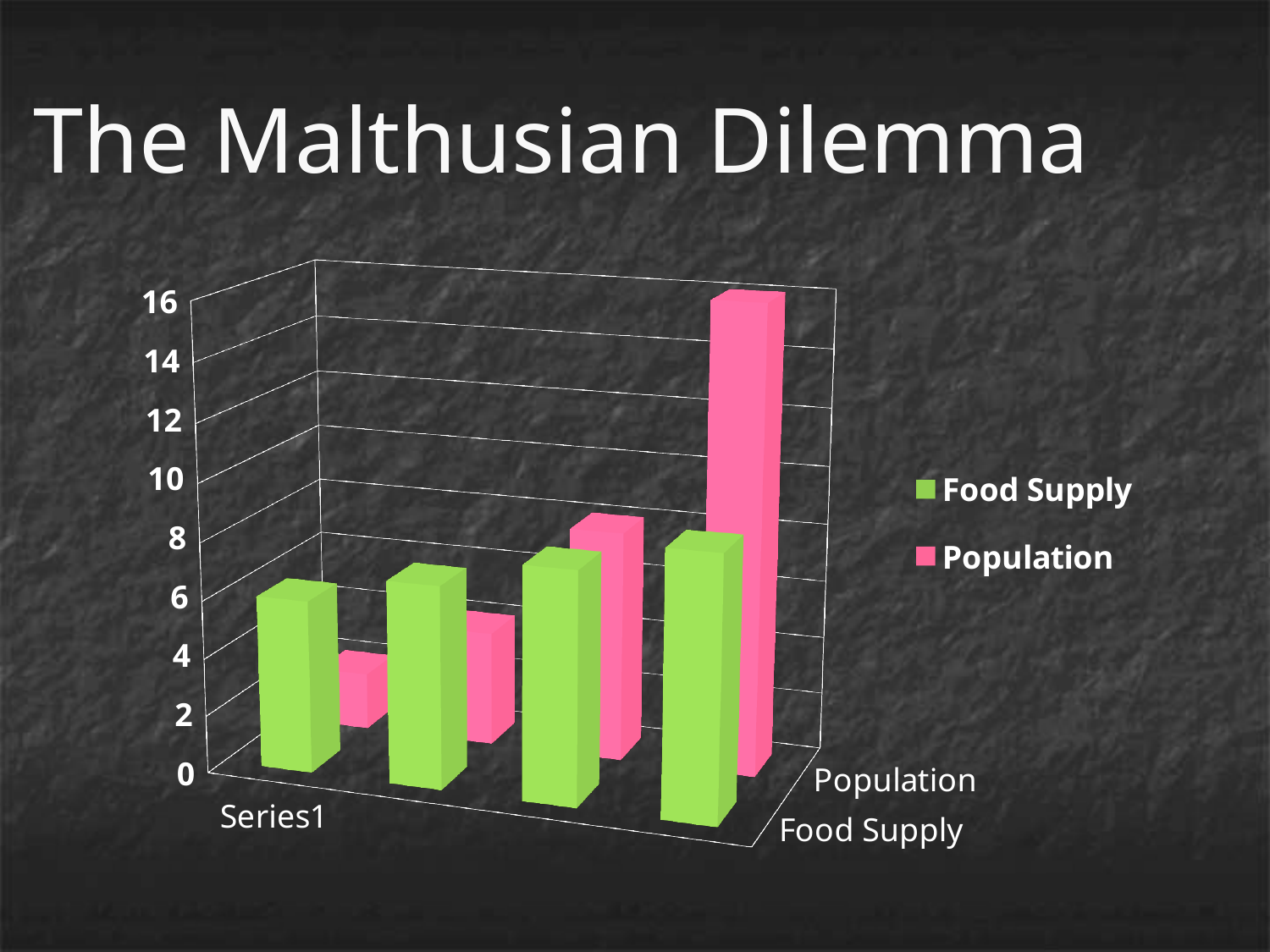
What kind of chart is shown on the slide? bar chart Which colour represents the Population series? pink How many bars are plotted for the Population series? 4 Is the value of the leftmost Population bar greater or less than 6? less In the rightmost group of bars, which is larger: Food Supply or Population? Population Do the Food Supply bars rise or fall from left to right? rise Do the Population bars rise or fall from left to right? rise How many series does the legend list? 2 What are the two series named in the legend? Food Supply and Population Which series contains the tallest bar on the chart? Population Is the value of the tallest Population bar greater or less than 12? greater In the leftmost group of bars (Series1), which is larger: Food Supply or Population? Food Supply